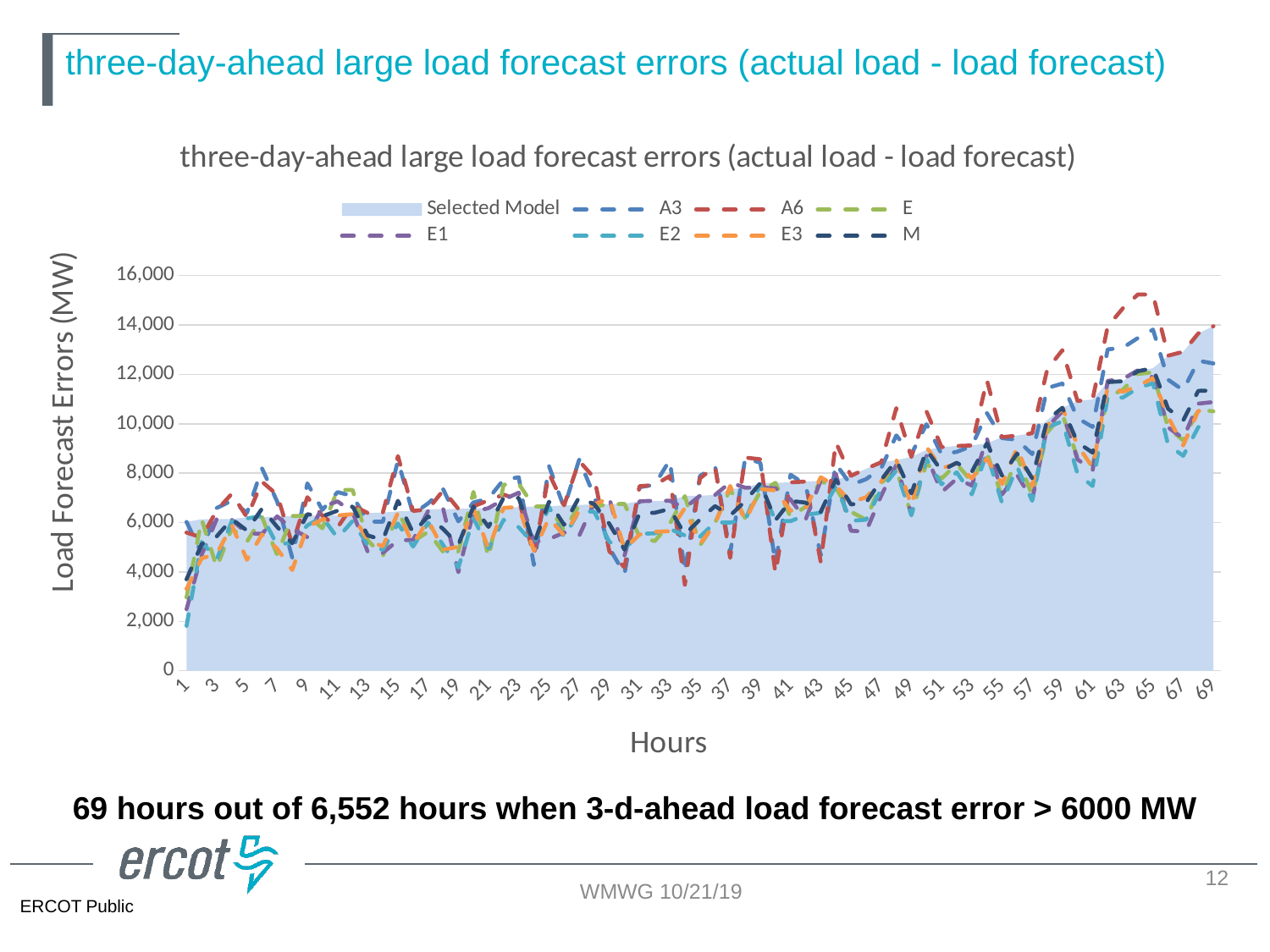
What is the highest value shown on the y axis? 16,000 Do the Selected Model values generally rise or fall as the hours increase along the x axis? rise What is the label of the x axis? Hours What is the label of the y axis? Load Forecast Errors (MW) Is the Selected Model value at hour 69 greater or less than 12,000? greater Which series reaches the highest value on the chart? A6 Is the peak value of the A6 series (around hour 64) greater or less than 14,000? greater Which series is drawn as a shaded area rather than a dashed line? Selected Model What is the last hour shown on the x axis? 69 Is the Selected Model value at hour 1 greater or less than 8,000? less How many series does the chart legend list? 8